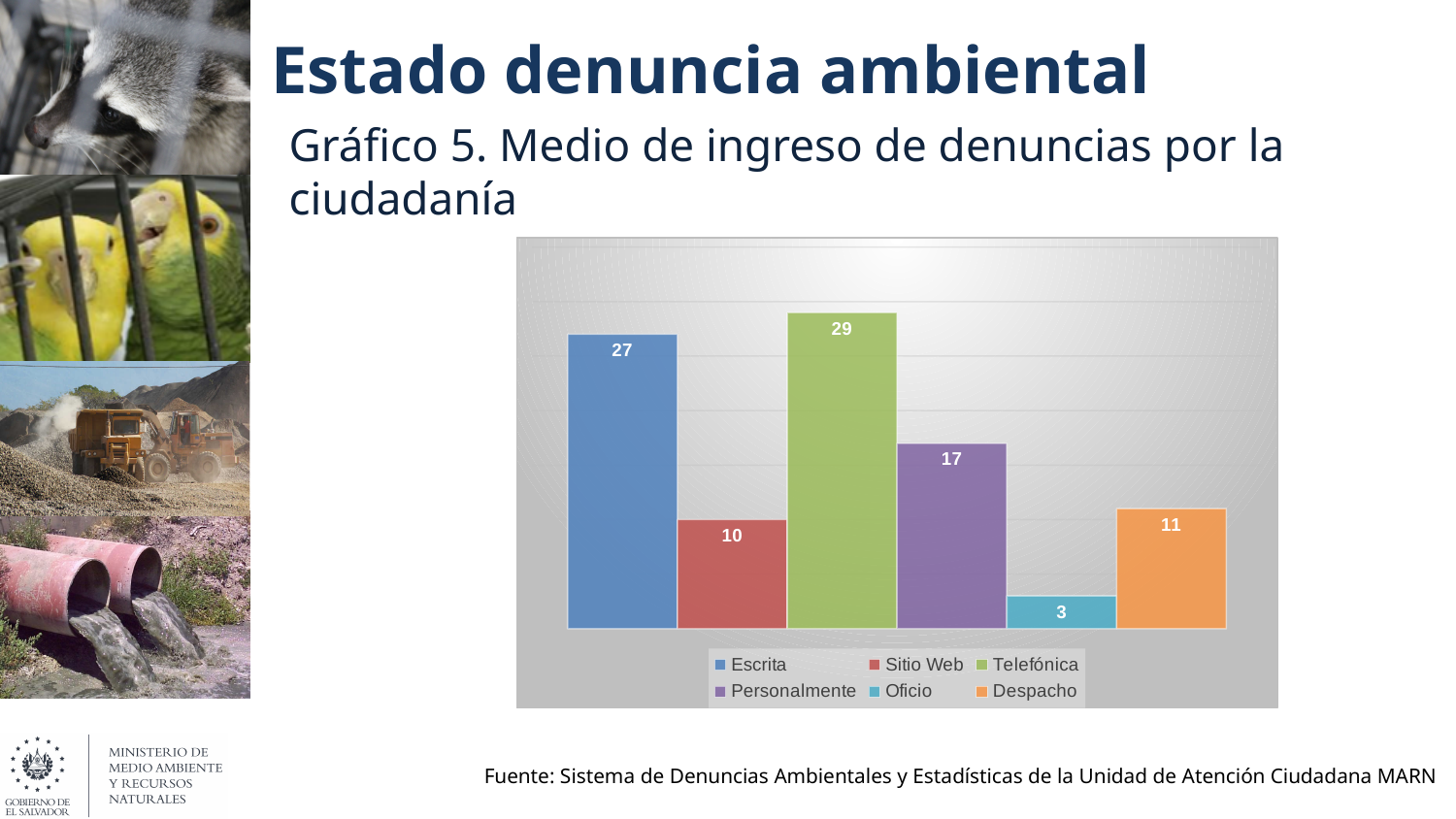
Which is larger, the value for Personalmente or the value for Sitio Web? Personalmente What is the value for Oficio? 3 How many categories are shown in the chart? 6 What is the value for Sitio Web? 10 Which category has the highest value? Telefónica What is the difference between the values for Telefónica and Escrita? 2 What is the value for Despacho? 11 What is the value for Escrita? 27 What is the difference between the values for Personalmente and Despacho? 6 What kind of chart is shown on the slide? Bar chart What colour is the bar for Telefónica? Green Which category has the lowest value? Oficio